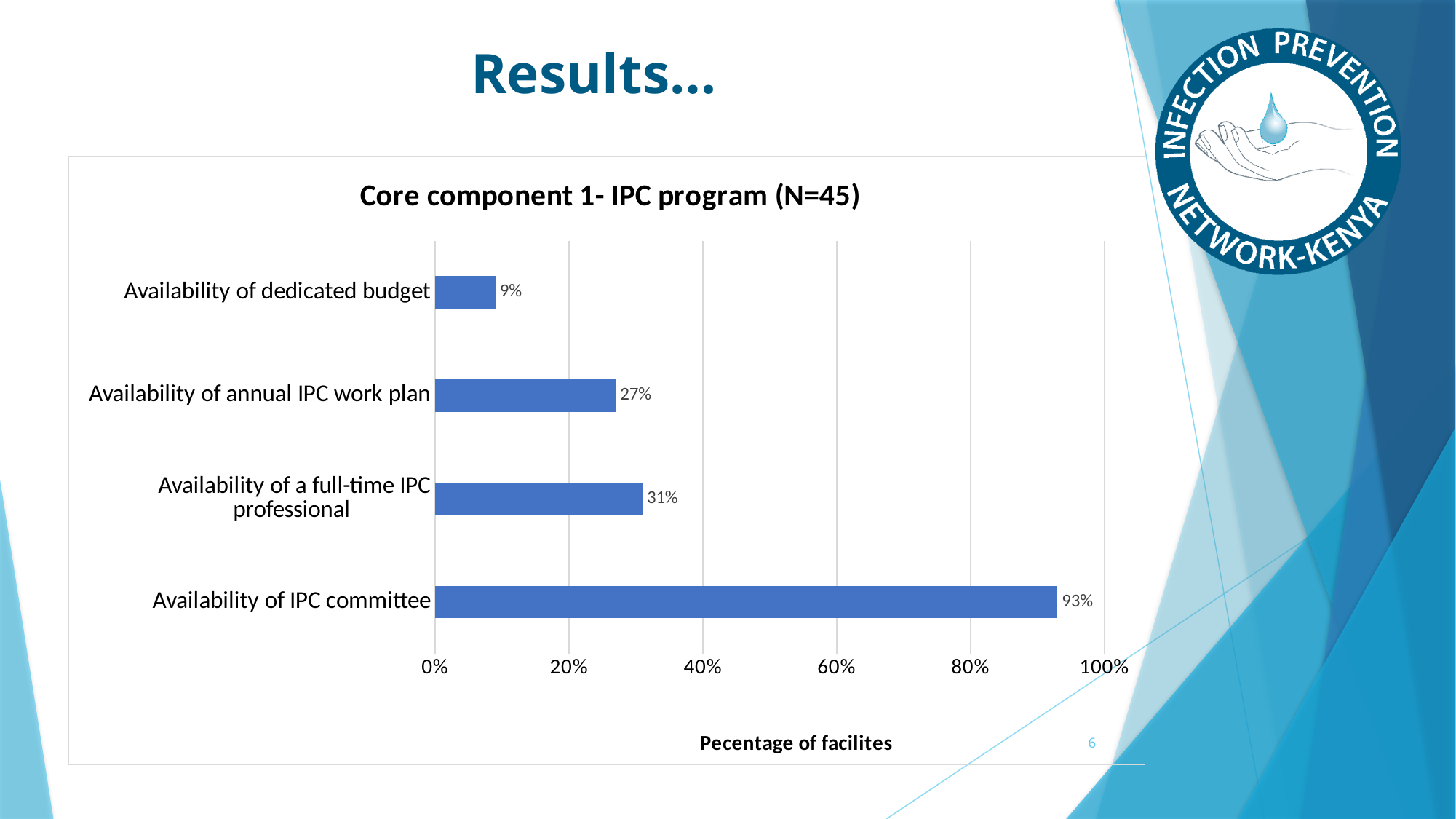
What is the value for Availability of a full-time IPC professional? 31% What is the value for Availability of dedicated budget? 9% What percentage of facilities have an annual IPC work plan? 27% Which category has the highest value? Availability of IPC committee What percentage of facilities have an IPC committee available? 93% What is the title of the chart? Core component 1- IPC program (N=45) What is the difference between the values for Availability of IPC committee and Availability of dedicated budget? 84% How many categories are shown in the chart? 4 Is the value for Availability of IPC committee greater or less than 80%? greater Which is larger: the value for Availability of a full-time IPC professional or Availability of annual IPC work plan? Availability of a full-time IPC professional What kind of chart is shown on the slide? Bar chart Which category has the lowest value? Availability of dedicated budget